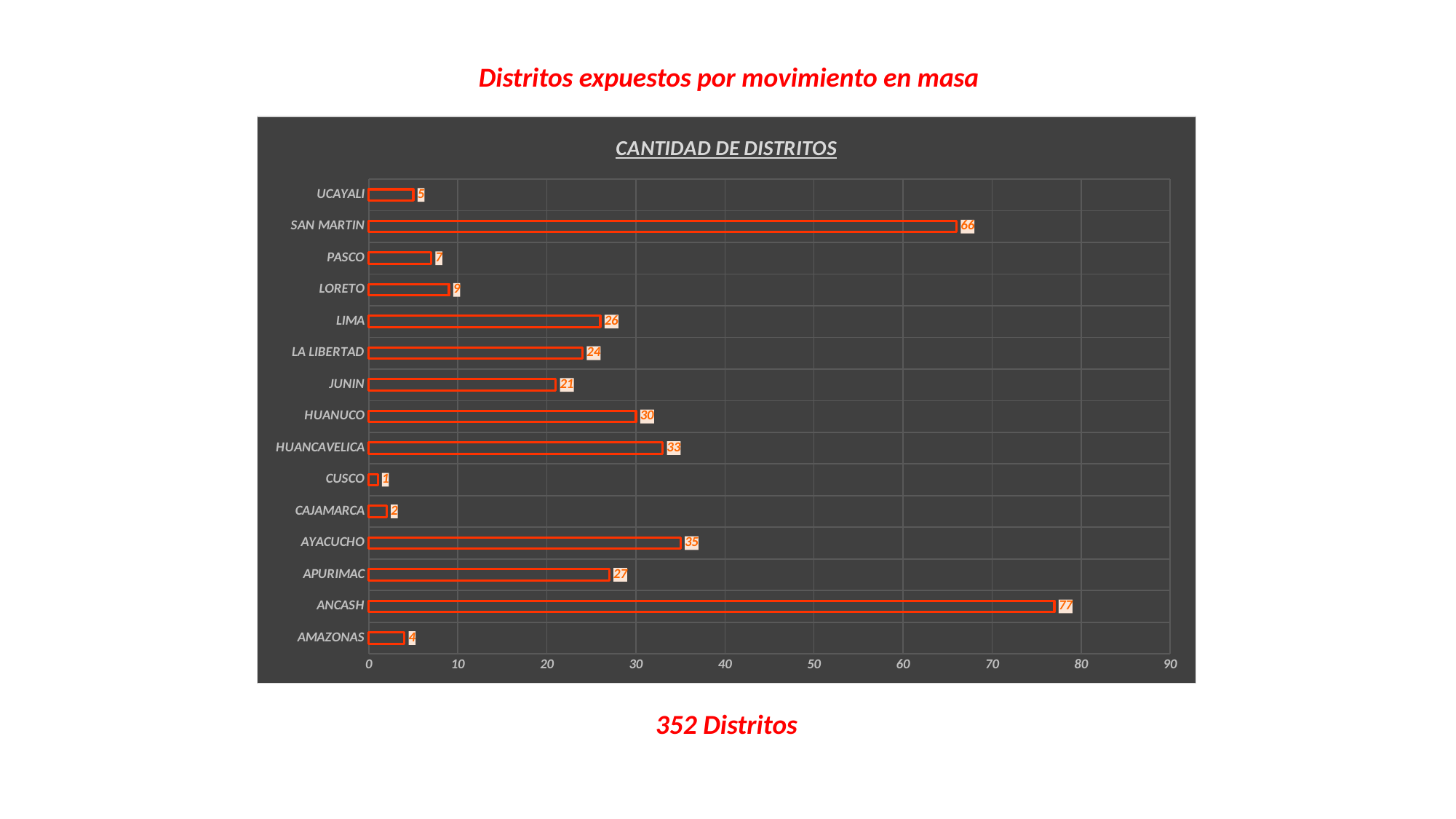
Which category has the lowest value? CUSCO What is the difference between the values for ANCASH and SAN MARTIN? 11 Is the value for LIMA greater or less than 20? greater What is the difference between the values for LIMA and LA LIBERTAD? 2 What is the value for CUSCO? 1 What is the value for SAN MARTIN? 66 What kind of chart is shown on the slide? bar chart Which category has the highest value? ANCASH What is the value for HUANCAVELICA? 33 Which is larger, the value for AYACUCHO or the value for HUANUCO? AYACUCHO What is the title of the chart? CANTIDAD DE DISTRITOS How many categories are shown in the chart? 15